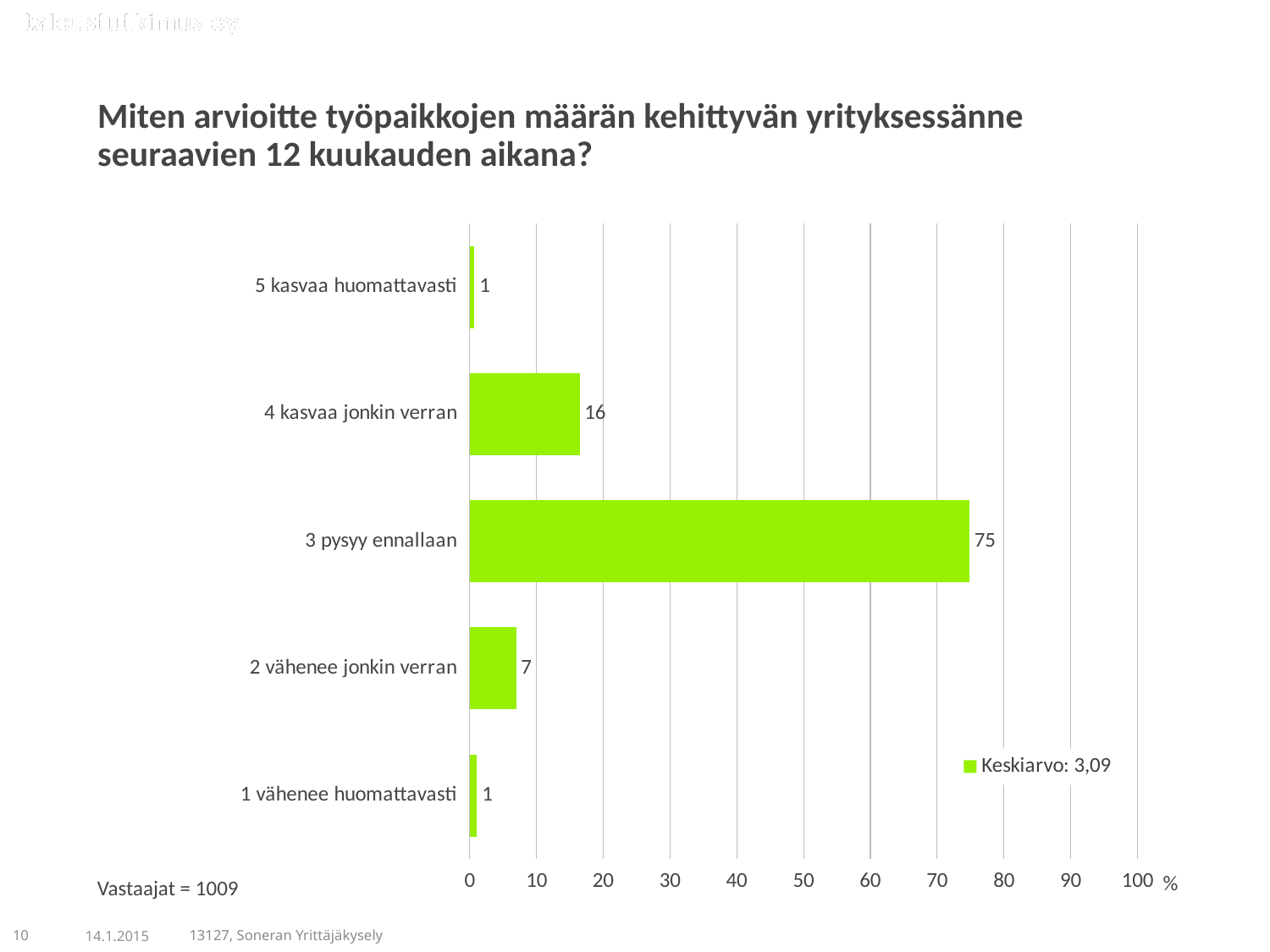
Which category has the highest value? 3 pysyy ennallaan How many categories are shown in the chart? 5 What does the legend entry say? Keskiarvo: 3,09 What kind of chart is shown on the slide? bar chart What is the value for "4 kasvaa jonkin verran"? 16 What is the number of respondents (Vastaajat) shown on the slide? 1009 Which is larger, the value for "4 kasvaa jonkin verran" or the value for "2 vähenee jonkin verran"? 4 kasvaa jonkin verran What is the value for "2 vähenee jonkin verran"? 7 What is the difference between the values for "3 pysyy ennallaan" and "4 kasvaa jonkin verran"? 59 What is the value for "5 kasvaa huomattavasti"? 1 What is the value for "3 pysyy ennallaan"? 75 Is the value for "3 pysyy ennallaan" greater or less than 50? greater